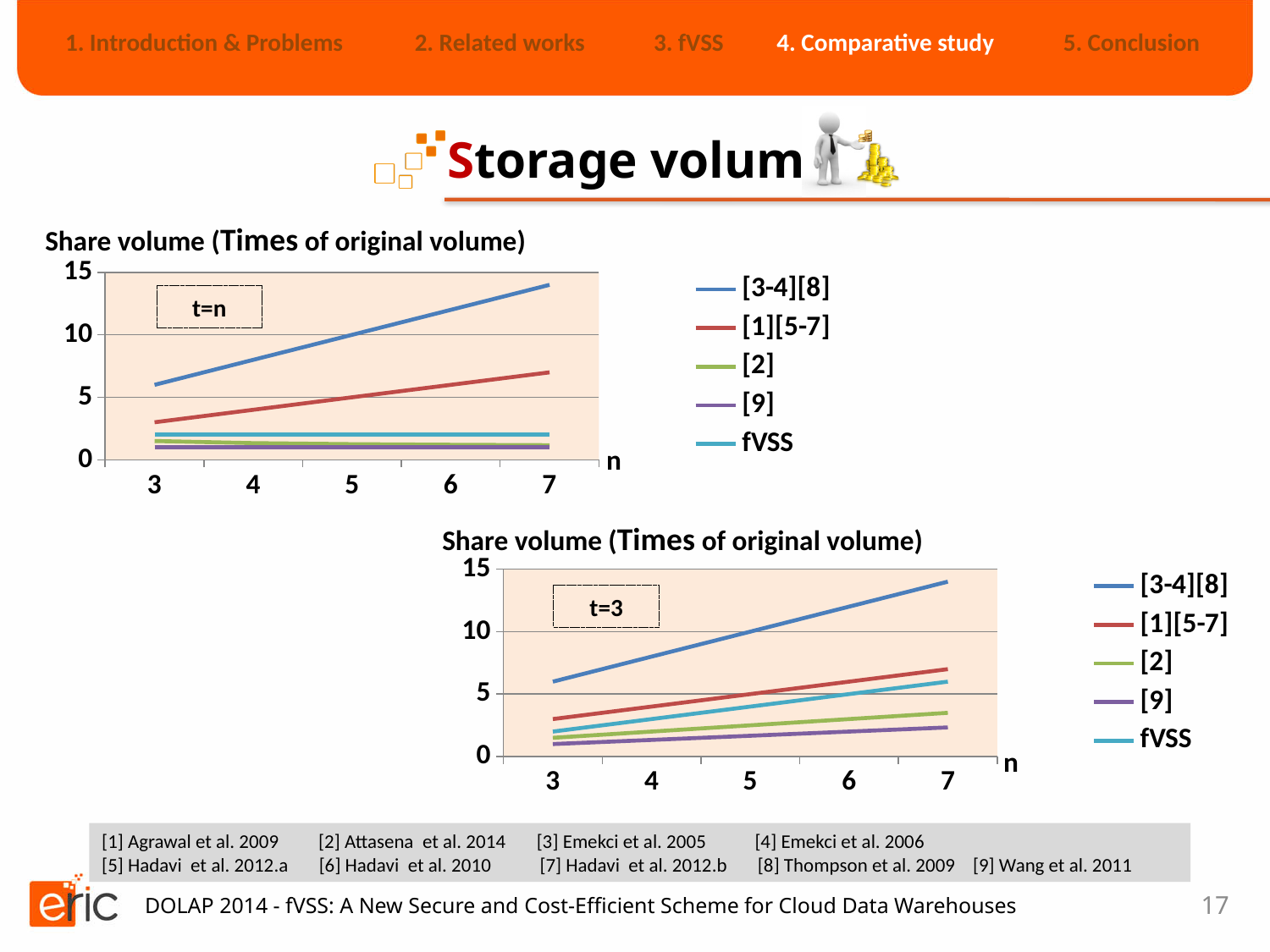
How many series does the legend of the bottom chart (t=3) list? 5 In the top chart (t=n), does the value for [3-4][8] rise or fall as n increases from 3 to 7? rise In the top chart (t=n), is the value for [1][5-7] at n=7 greater or less than 10? less In the bottom chart (t=3), is the value for fVSS at n=7 greater or less than 5? greater In the top chart (t=n), is the value for fVSS at n=7 greater or less than 5? less In the bottom chart (t=3), which series has the lowest value at n=7? [9] What kind of chart is the top chart (t=n)? line chart In the bottom chart (t=3), which is larger at n=7: [1][5-7] or fVSS? [1][5-7] In the bottom chart (t=3), which series has the highest value at n=7? [3-4][8] How many values of n are shown on the x axis of the top chart (t=n)? 5